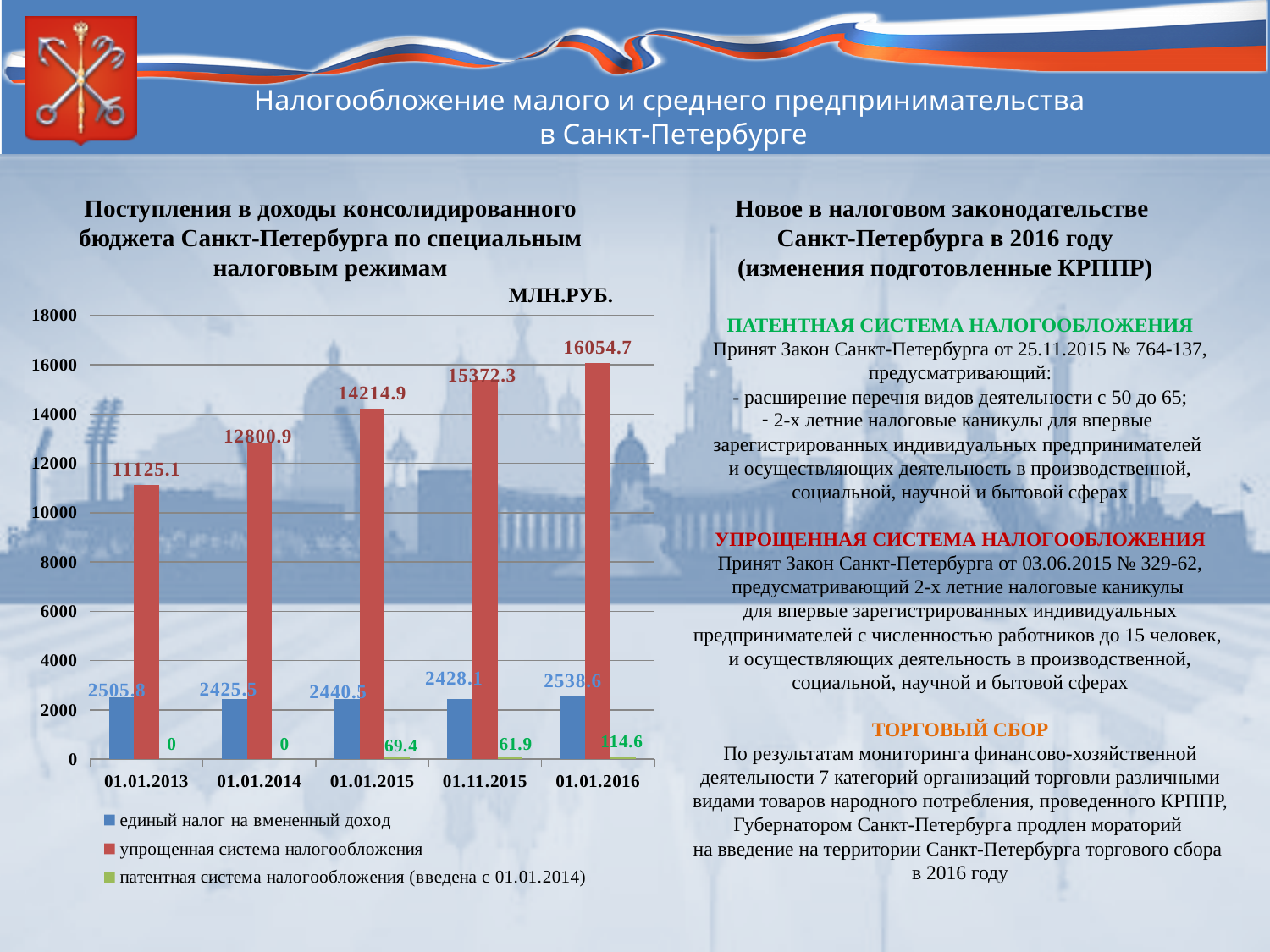
What is the value for упрощенная система налогообложения on 01.01.2016? 16054.7 What type of chart is shown on the slide? bar chart What unit is indicated above the chart? МЛН.РУБ. On which date is the value for упрощенная система налогообложения the lowest? 01.01.2013 Do the values for упрощенная система налогообложения rise or fall from 01.01.2013 to 01.01.2016? rise What is the difference between the упрощенная система налогообложения values on 01.01.2016 and 01.01.2013? 4929.6 Which is larger on 01.01.2015: единый налог на вмененный доход or упрощенная система налогообложения? упрощенная система налогообложения How many dates are shown on the x axis of the chart? 5 What is the value for патентная система налогообложения on 01.11.2015? 61.9 What is the value for единый налог на вмененный доход on 01.01.2013? 2505.8 On which date is the value for патентная система налогообложения the highest? 01.01.2016 How many series does the chart legend list? 3